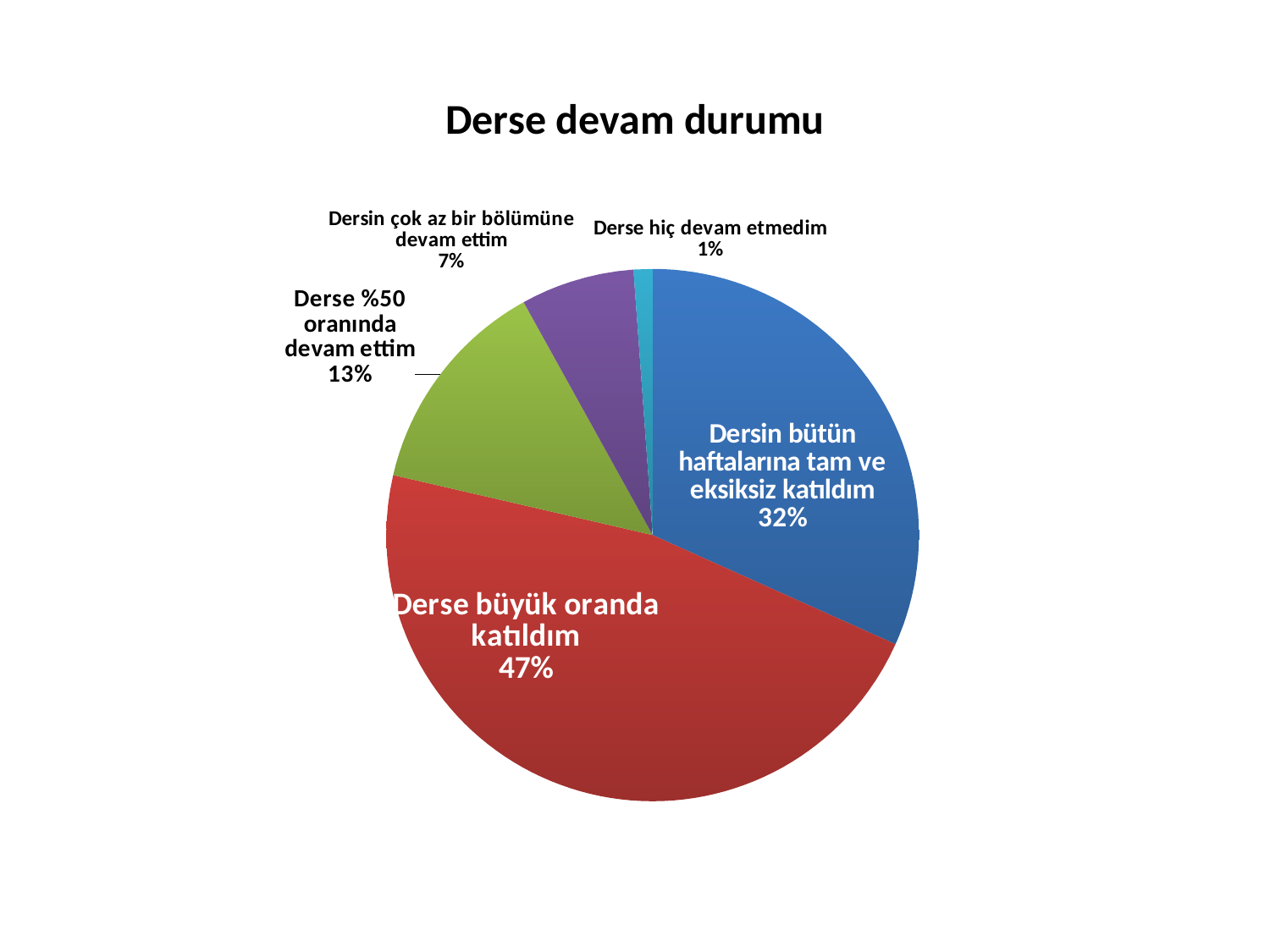
What percentage is shown for "Dersin çok az bir bölümüne devam ettim"? 7% Which category has the smallest share of the pie? Derse hiç devam etmedim Which category has the largest share of the pie? Derse büyük oranda katıldım What percentage is shown for "Derse %50 oranında devam ettim"? 13% What percentage is shown for "Derse büyük oranda katıldım"? 47% What is the difference in percentage points between "Derse büyük oranda katıldım" and "Dersin bütün haftalarına tam ve eksiksiz katıldım"? 15 Which is larger: the share for "Derse %50 oranında devam ettim" or for "Dersin çok az bir bölümüne devam ettim"? Derse %50 oranında devam ettim What percentage is shown for "Dersin bütün haftalarına tam ve eksiksiz katıldım"? 32% What percentage is shown for "Derse hiç devam etmedim"? 1% What type of chart is shown on the slide? pie chart What is the title of the chart? Derse devam durumu How many slices does the pie chart have? 5